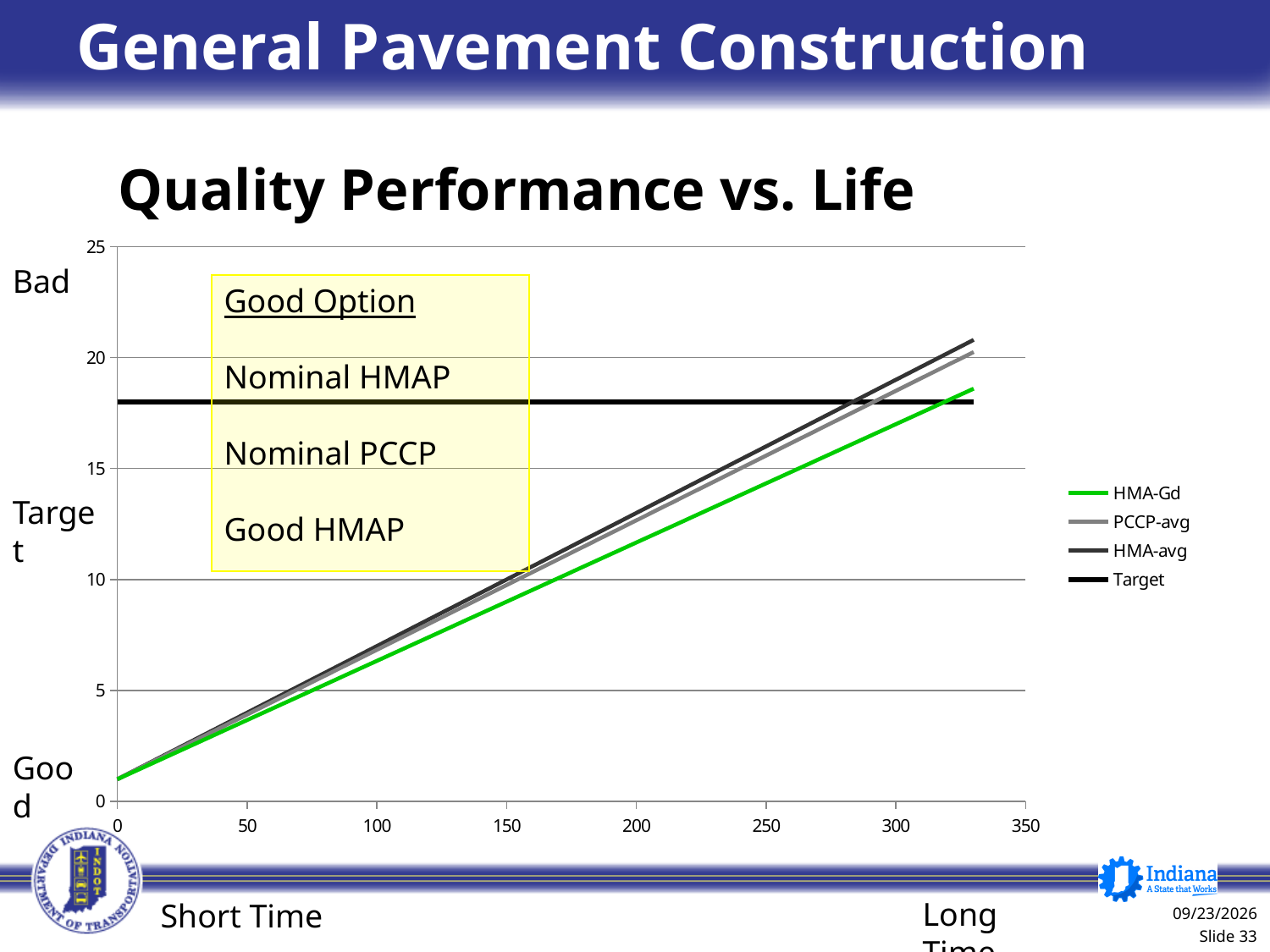
Is the value for HMA-Gd at x = 300 greater or less than 20? less Is the value for HMA-avg at x = 200 greater or less than 10? greater At x = 300, which is larger: HMA-avg or HMA-Gd? HMA-avg How many series does the chart legend list? 4 Does the Target line rise, fall, or stay flat across the x axis? stay flat Among the three sloped lines (HMA-Gd, PCCP-avg, HMA-avg), which has the lowest value at x = 300? HMA-Gd Is the value of the Target line greater or less than 15? greater What is the title of the chart? Quality Performance vs. Life What kind of chart is shown on the slide? line chart Which series is drawn in green in the chart? HMA-Gd Does the HMA-Gd line rise or fall as the x axis increases? rise